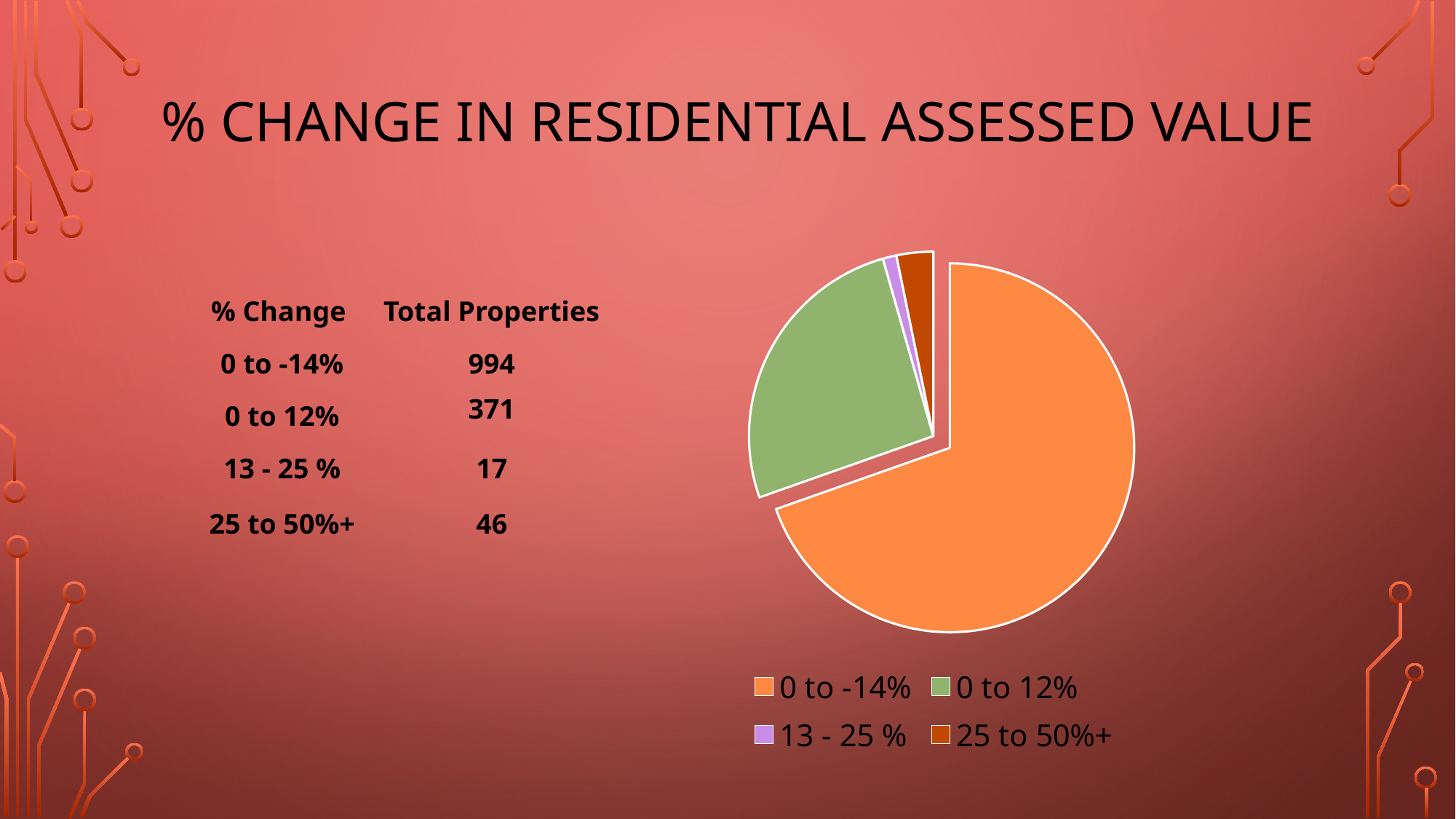
What is the total number of properties for the 25 to 50%+ category? 46 What is the total number of properties for the 13 - 25 % category? 17 What is the total number of properties for the 0 to -14% category? 994 Which category has the smallest slice of the pie chart? 13 - 25 % What colour is the slice for the 0 to 12% category in the pie chart? Green What is the total number of properties for the 0 to 12% category? 371 What kind of chart is shown on the slide? Pie chart Which category has more properties, 25 to 50%+ or 13 - 25 %? 25 to 50%+ How many entries does the legend of the pie chart list? 4 How many slices does the pie chart have? 4 What is the difference in total properties between the 0 to -14% and 0 to 12% categories? 623 Which category has the largest slice of the pie chart? 0 to -14%